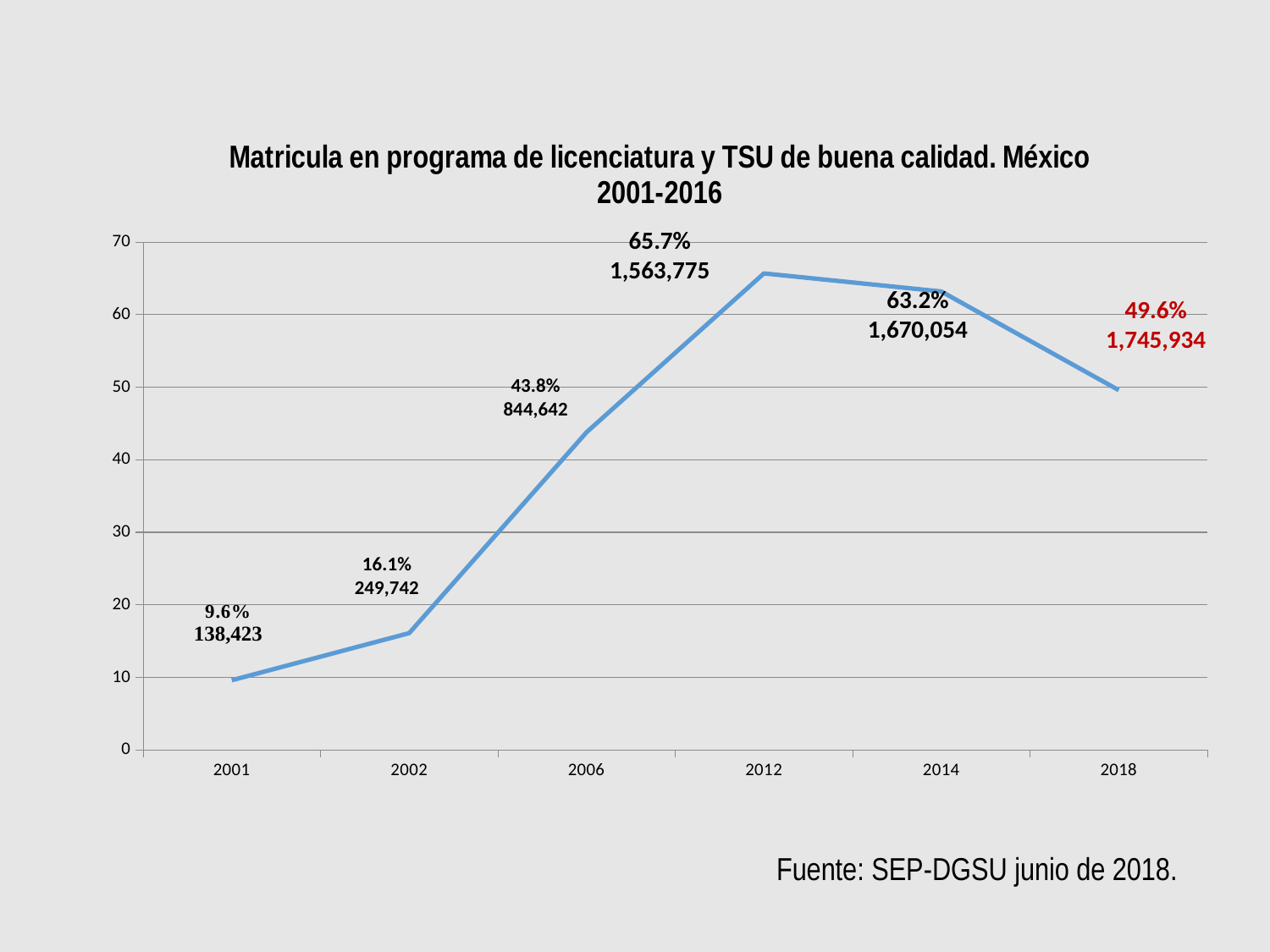
Which year has the lowest percentage value on the line? 2001 Is the value for 2006 greater or less than 40? greater Which year has the highest percentage value on the line? 2012 Which year has the larger percentage value, 2006 or 2018? 2018 What enrollment figure is labelled for 2018? 1,745,934 How many years are plotted on the x axis? 6 What percentage is labelled for 2001? 9.6% What kind of chart is shown on the slide? Line chart What percentage is labelled for 2012? 65.7% Does the line rise or fall between 2014 and 2018? Fall What is the difference in percentage points between the 2012 value (65.7%) and the 2014 value (63.2%)? 2.5 What enrollment figure is labelled for 2006? 844,642